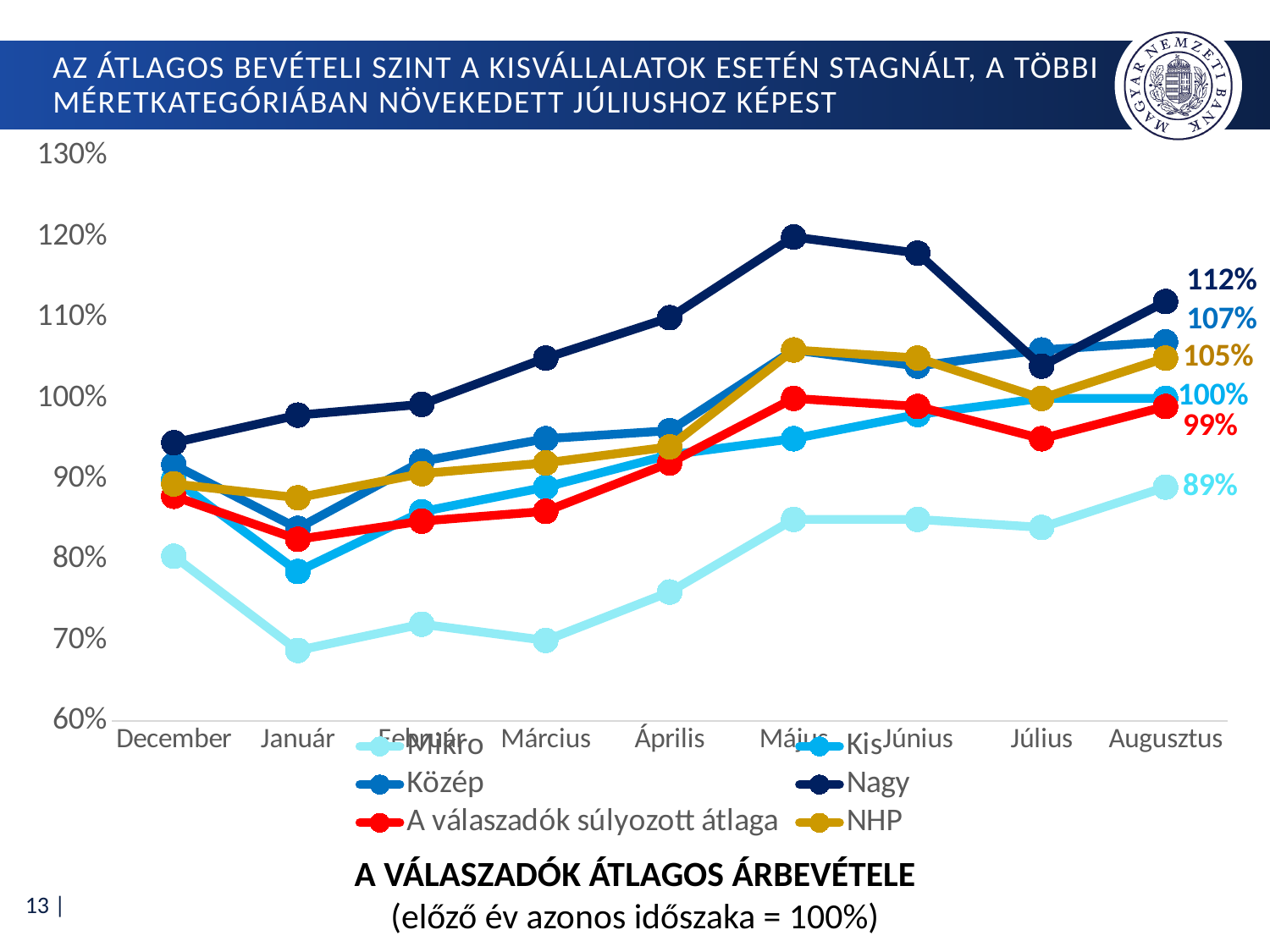
What is the difference between the Augusztus values of Nagy and Közép? 5 percentage points How many months are shown along the x axis? 9 What is the value for Mikro in Augusztus? 89% Which series has the lowest value in Augusztus? Mikro What is the value for A válaszadók súlyozott átlaga in Augusztus? 99% What is the value for NHP in Augusztus? 105% What is the value for Nagy in Augusztus? 112% Which series has the highest value in Augusztus? Nagy Is the value for Nagy in Május greater or less than 110%? greater How many series does the legend list? 6 What kind of chart is shown on the slide? line chart Is the value for Mikro in Január greater or less than 70%? less